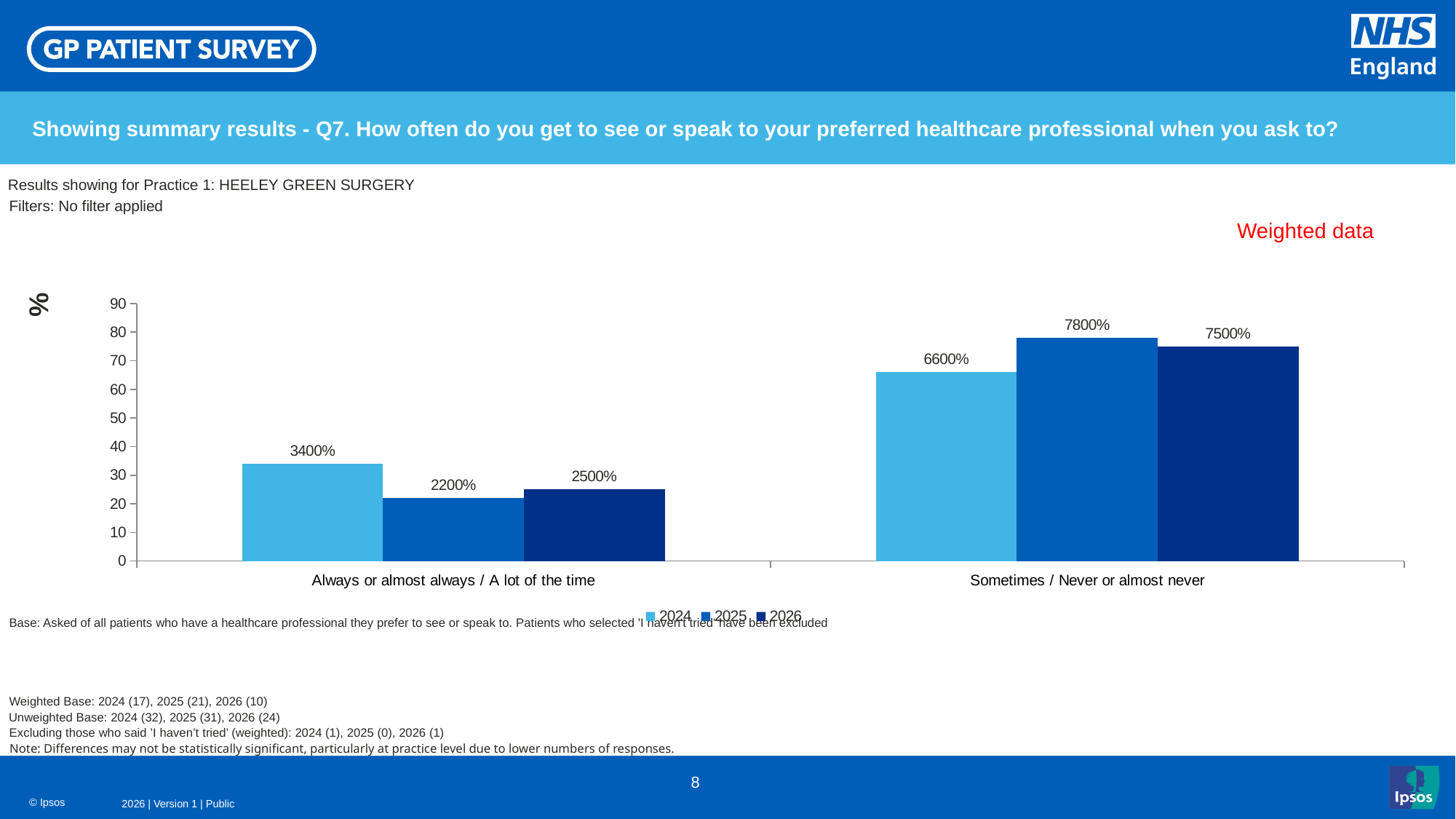
What is the data label for 2026 in the 'Always or almost always / A lot of the time' category? 2500% How many series does the legend list? 3 What type of chart is shown on the slide? bar chart How many categories are shown on the x axis? 2 What is the data label for 2025 in the 'Sometimes / Never or almost never' category? 7800% Is the 2026 bar for 'Sometimes / Never or almost never' above or below the 70 mark on the axis? above Which practice are the results shown for? HEELEY GREEN SURGERY Is the 2025 bar for 'Always or almost always / A lot of the time' larger or smaller than the 2026 bar in the same category? smaller What is the data label for 2024 in the 'Sometimes / Never or almost never' category? 6600% Which year has the highest bar in the 'Sometimes / Never or almost never' category? 2025 Which year has the lowest bar in the 'Always or almost always / A lot of the time' category? 2025 What is the data label for 2024 in the 'Always or almost always / A lot of the time' category? 3400%